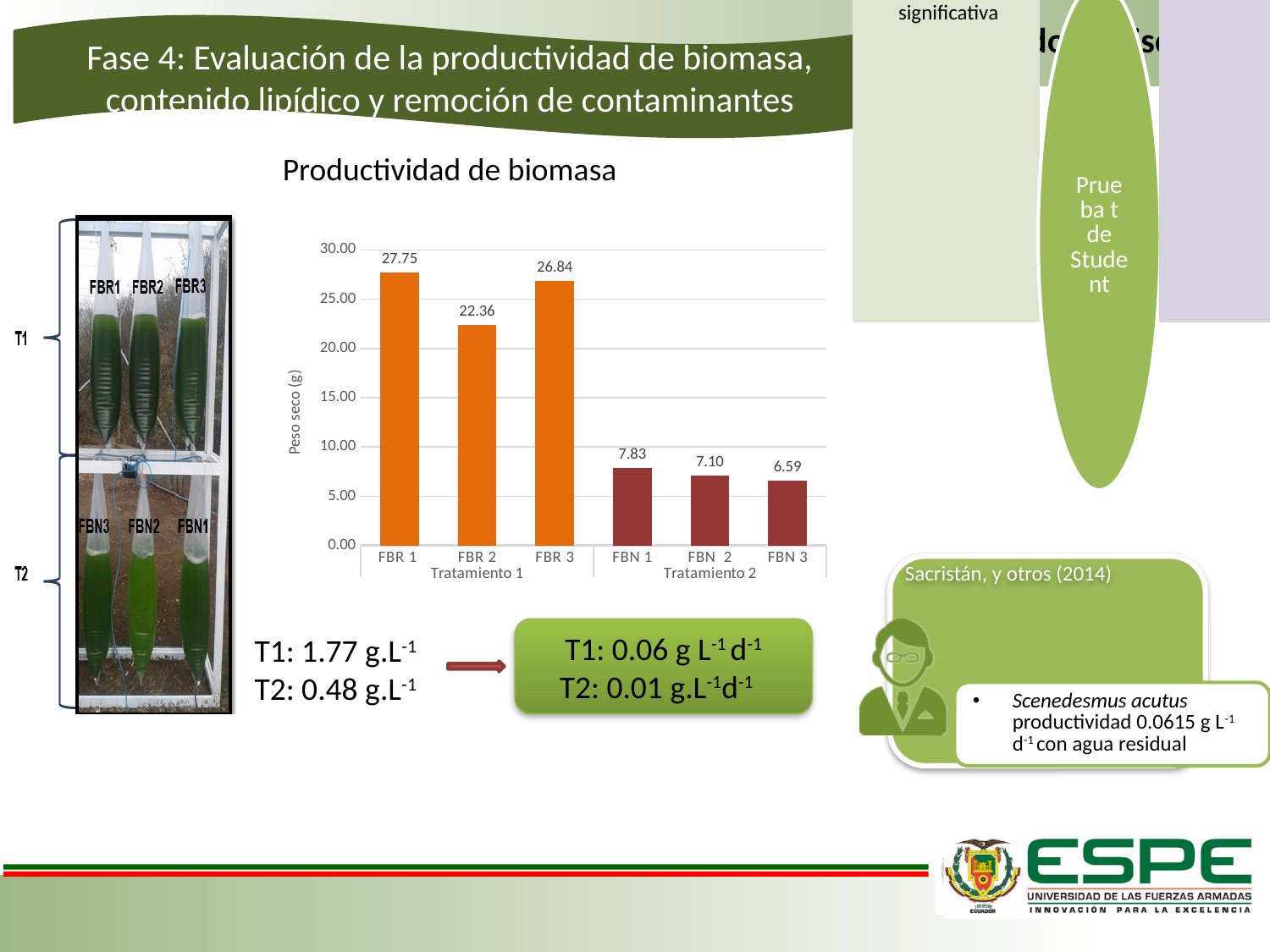
What is the difference between the values for FBR 1 and FBR 2? 5.39 Which category has the lowest value? FBN 3 What is the value for FBN 2? 7.10 Which is larger, the value for FBR 2 or the value for FBN 1? FBR 2 How many bars are shown in the chart? 6 Which category has the highest value? FBR 1 What kind of chart is shown on the slide? bar chart What is the value for FBR 1? 27.75 What is the label of the vertical axis of the chart? Peso seco (g) What is the value for FBR 3? 26.84 What is the difference between the values for FBN 1 and FBN 3? 1.24 Is the value for FBR 2 greater or less than 20.00? greater